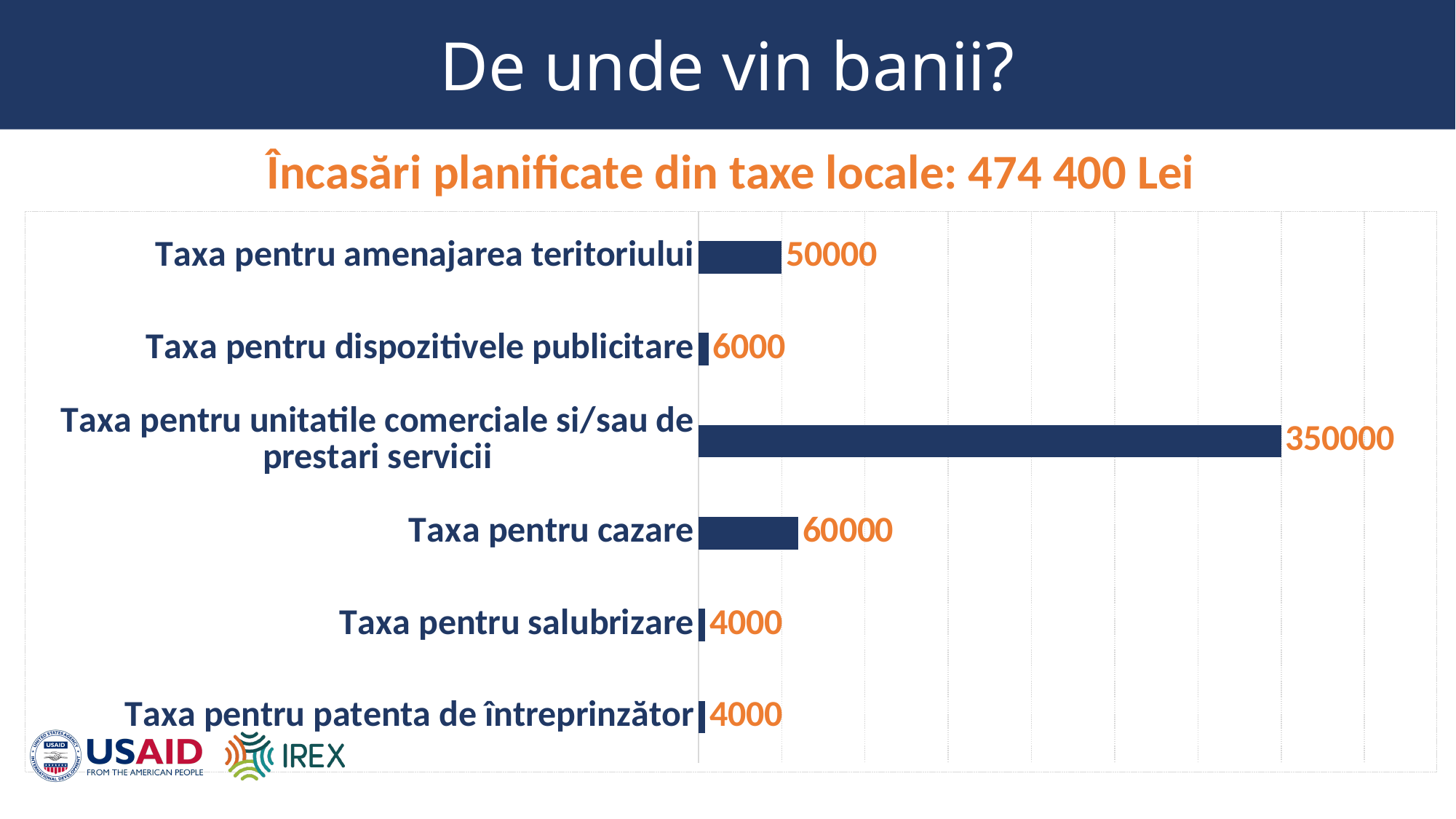
Which category has the highest value? Taxa pentru unitatile comerciale si/sau de prestari servicii What is the title shown above the chart? Încasări planificate din taxe locale: 474 400 Lei Which is larger, the value for Taxa pentru cazare or the value for Taxa pentru amenajarea teritoriului? Taxa pentru cazare What is the value for Taxa pentru dispozitivele publicitare? 6000 What is the value for Taxa pentru unitatile comerciale si/sau de prestari servicii? 350000 What is the value for Taxa pentru amenajarea teritoriului? 50000 What is the difference between the value for Taxa pentru cazare and the value for Taxa pentru amenajarea teritoriului? 10000 What is the value for Taxa pentru salubrizare? 4000 How many categories are shown in the chart? 6 What is the value for Taxa pentru cazare? 60000 What kind of chart is shown on the slide? Bar chart What is the difference between the value for Taxa pentru unitatile comerciale si/sau de prestari servicii and the value for Taxa pentru cazare? 290000